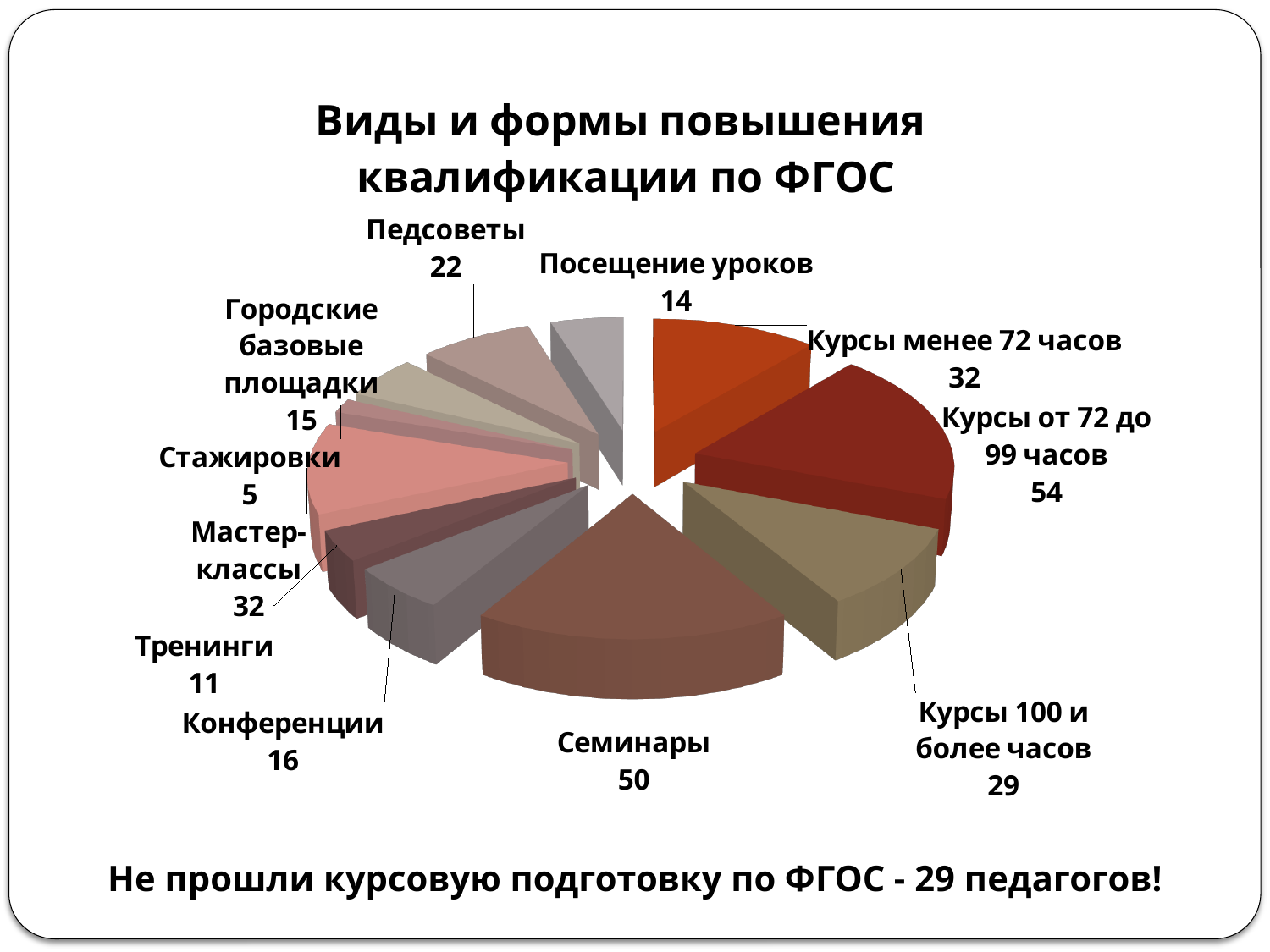
What is the value for Курсы от 72 до 99 часов? 54 What is the title of the chart? Виды и формы повышения квалификации по ФГОС What is the difference between the values for Курсы менее 72 часов and Посещение уроков? 18 Which category has the smallest value? Стажировки Which is larger, the value for Педсоветы or the value for Конференции? Педсоветы What is the value for Стажировки? 5 Which category has the largest value? Курсы от 72 до 99 часов How many categories does the pie chart have? 11 What type of chart is shown on the slide? pie chart What is the value for Семинары? 50 What is the difference between the values for Курсы от 72 до 99 часов and Семинары? 4 What is the value for Городские базовые площадки? 15